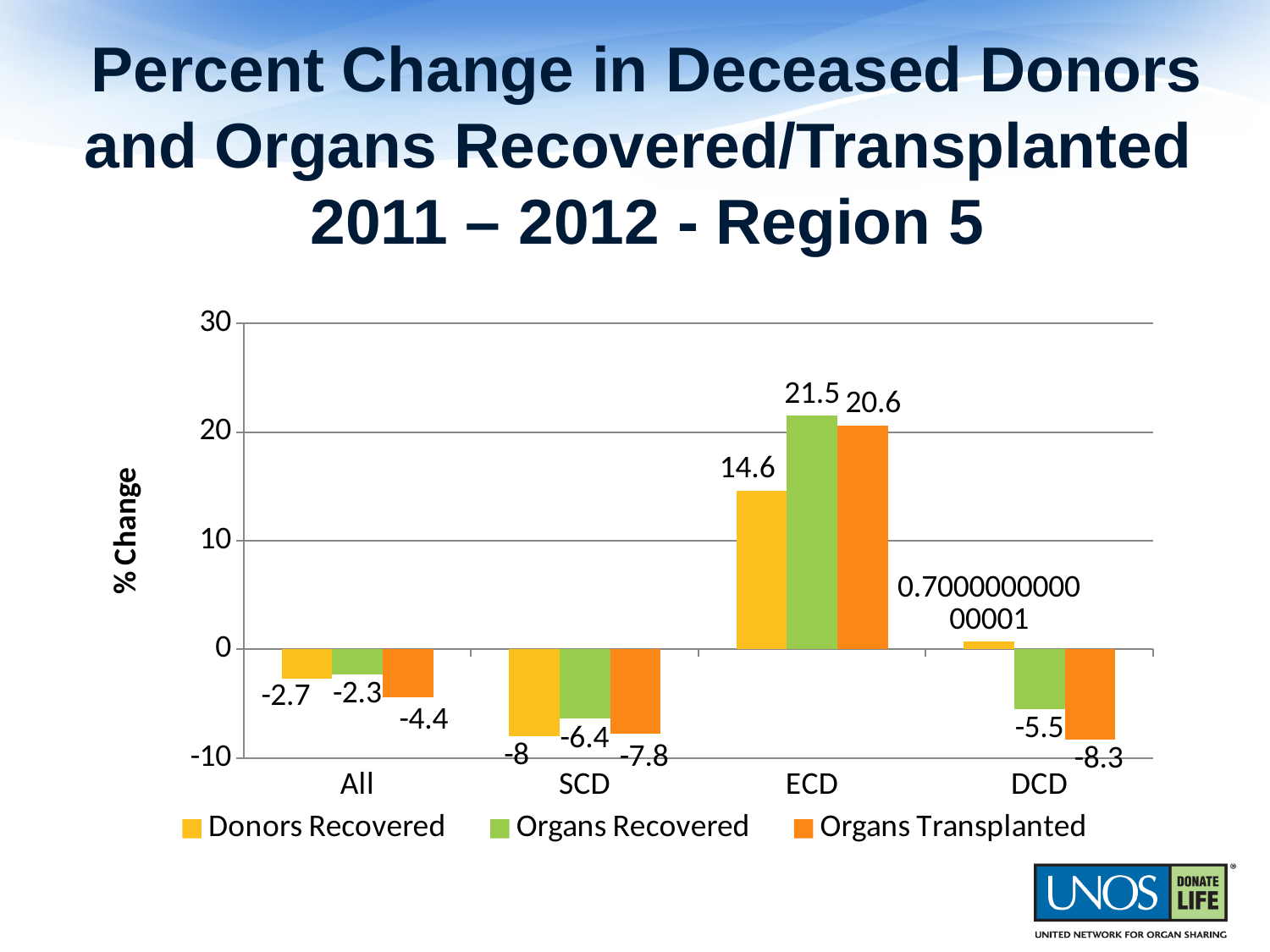
Is the value for Organs Transplanted in the ECD category greater or less than 10? greater What is the value for Organs Transplanted in the DCD category? -8.3 Which category has the lowest value for Organs Transplanted? DCD What is the value for Organs Recovered in the ECD category? 21.5 Which category has the highest value for Donors Recovered? ECD What is the value for Donors Recovered in the SCD category? -8 How many categories are shown on the x axis? 4 Which is larger in the SCD category, Organs Recovered or Organs Transplanted? Organs Recovered What is the difference between Organs Recovered and Donors Recovered in the ECD category? 6.9 What is the value for Organs Transplanted in the All category? -4.4 What type of chart is shown on the slide? bar chart How many series does the legend list? 3